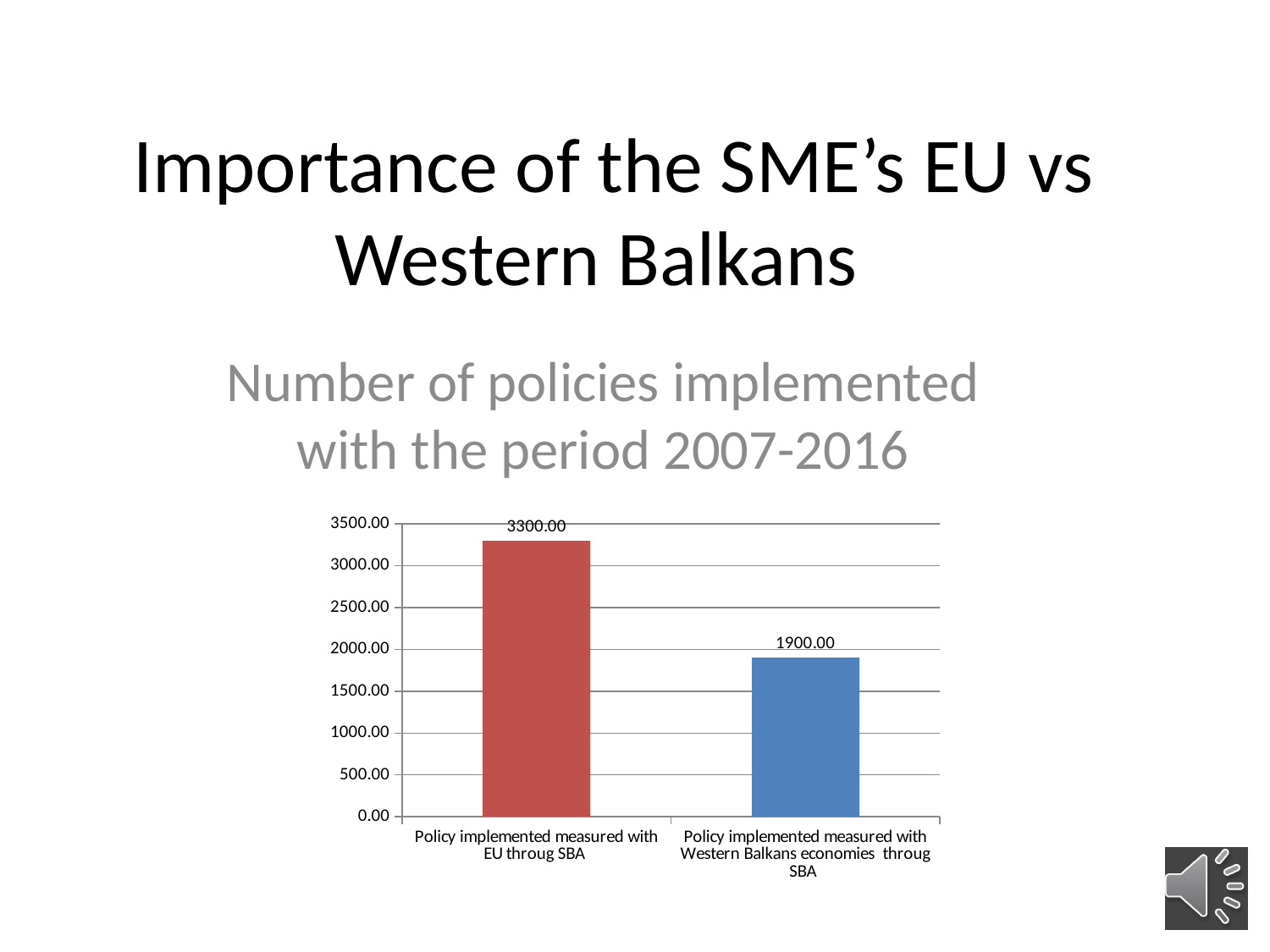
What is the value for 'Policy implemented measured with EU throug SBA'? 3300.00 What kind of chart is shown on the slide? bar chart Is the value for EU greater or less than 3000.00? greater Which category has the highest value? Policy implemented measured with EU throug SBA What colour is the bar for 'Policy implemented measured with EU throug SBA'? red What is the difference between the EU value and the Western Balkans value? 1400.00 What is the highest value shown on the vertical axis? 3500.00 What is the value for 'Policy implemented measured with Western Balkans economies throug SBA'? 1900.00 Which is larger, the value for EU or the value for Western Balkans economies? EU How many categories are shown in the chart? 2 Which category has the lowest value? Policy implemented measured with Western Balkans economies throug SBA Is the value for Western Balkans economies greater or less than 2000.00? less